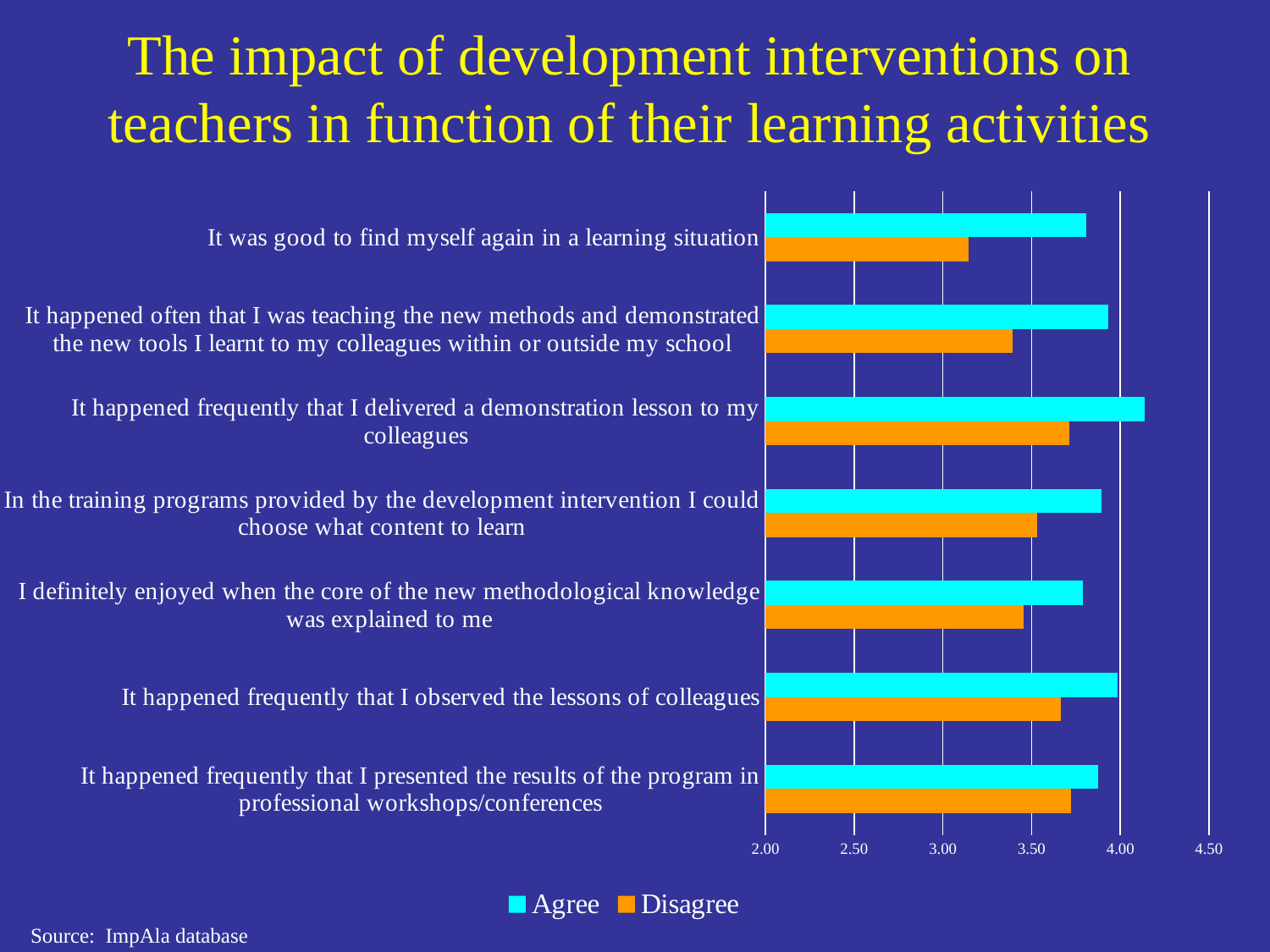
Is the Disagree value for "It was good to find myself again in a learning situation" greater or less than 3.50? less How many series does the legend list? 2 How many statements (categories) are plotted on the chart? 7 For "It happened frequently that I observed the lessons of colleagues", which is larger, the Agree value or the Disagree value? Agree Is the Disagree value for "It happened often that I was teaching the new methods and demonstrated the new tools I learnt to my colleagues within or outside my school" greater or less than 3.50? less Is the Agree value for "It was good to find myself again in a learning situation" greater or less than 4.00? less What colour are the Disagree bars in the chart? orange What kind of chart is shown on the slide? bar chart Which statement has the highest Agree value? It happened frequently that I delivered a demonstration lesson to my colleagues Which statement has the lowest Disagree value? It was good to find myself again in a learning situation Which is larger: the Disagree value for "It was good to find myself again in a learning situation" or the Disagree value for "It happened frequently that I delivered a demonstration lesson to my colleagues"? It happened frequently that I delivered a demonstration lesson to my colleagues